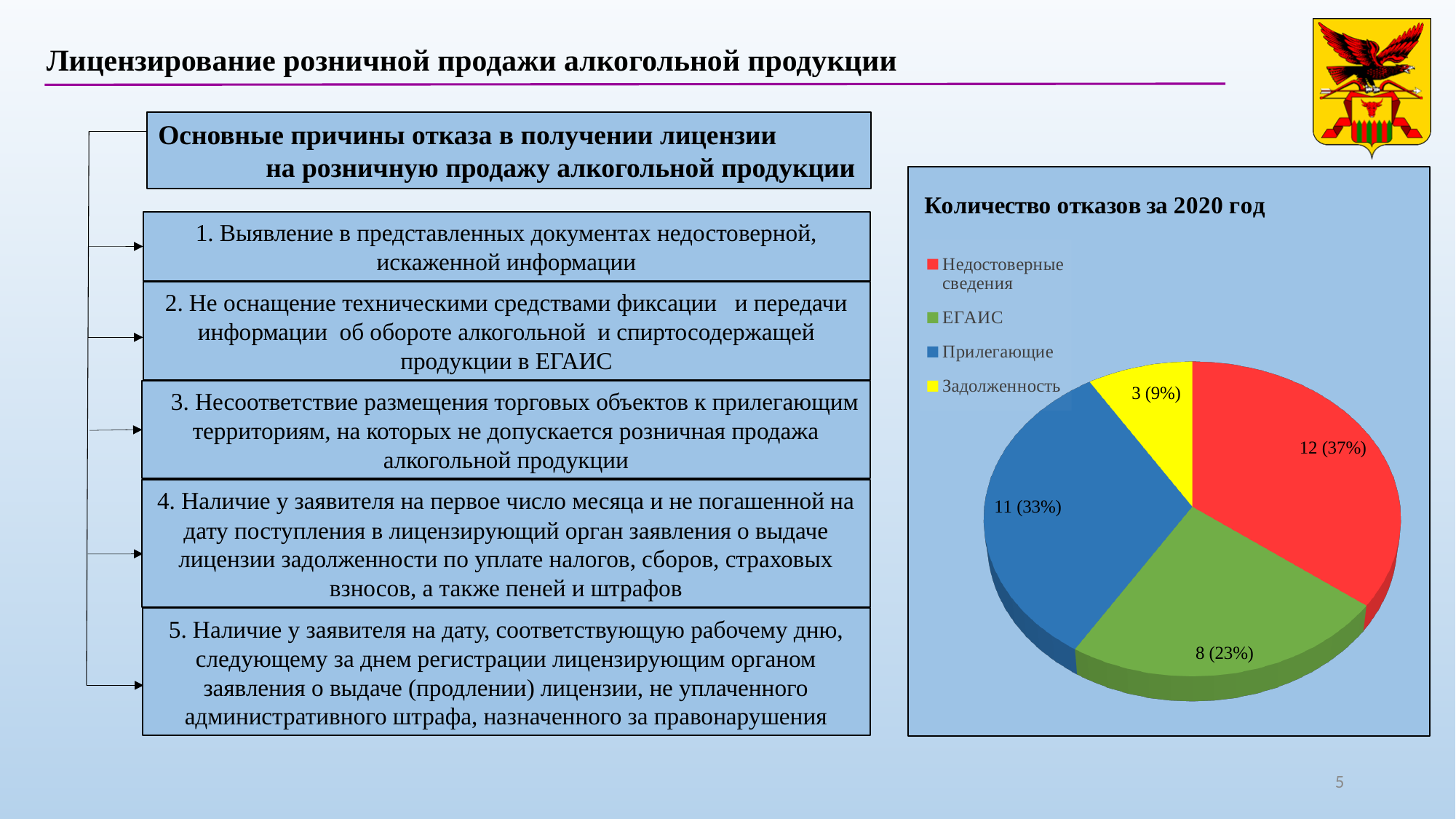
How many entries does the legend list? 4 Which category has the smallest slice? Задолженность What is the title of the chart? Количество отказов за 2020 год What is the difference between the values for Недостоверные сведения and ЕГАИС? 4 What is the value for Прилегающие? 11 Which category has the largest slice? Недостоверные сведения What kind of chart is shown on the slide? pie chart Which is larger, the value for Прилегающие or the value for ЕГАИС? Прилегающие What is the value for Недостоверные сведения? 12 How many slices does the pie chart have? 4 What share of the pie does Задолженность represent? 9% What is the value for ЕГАИС? 8